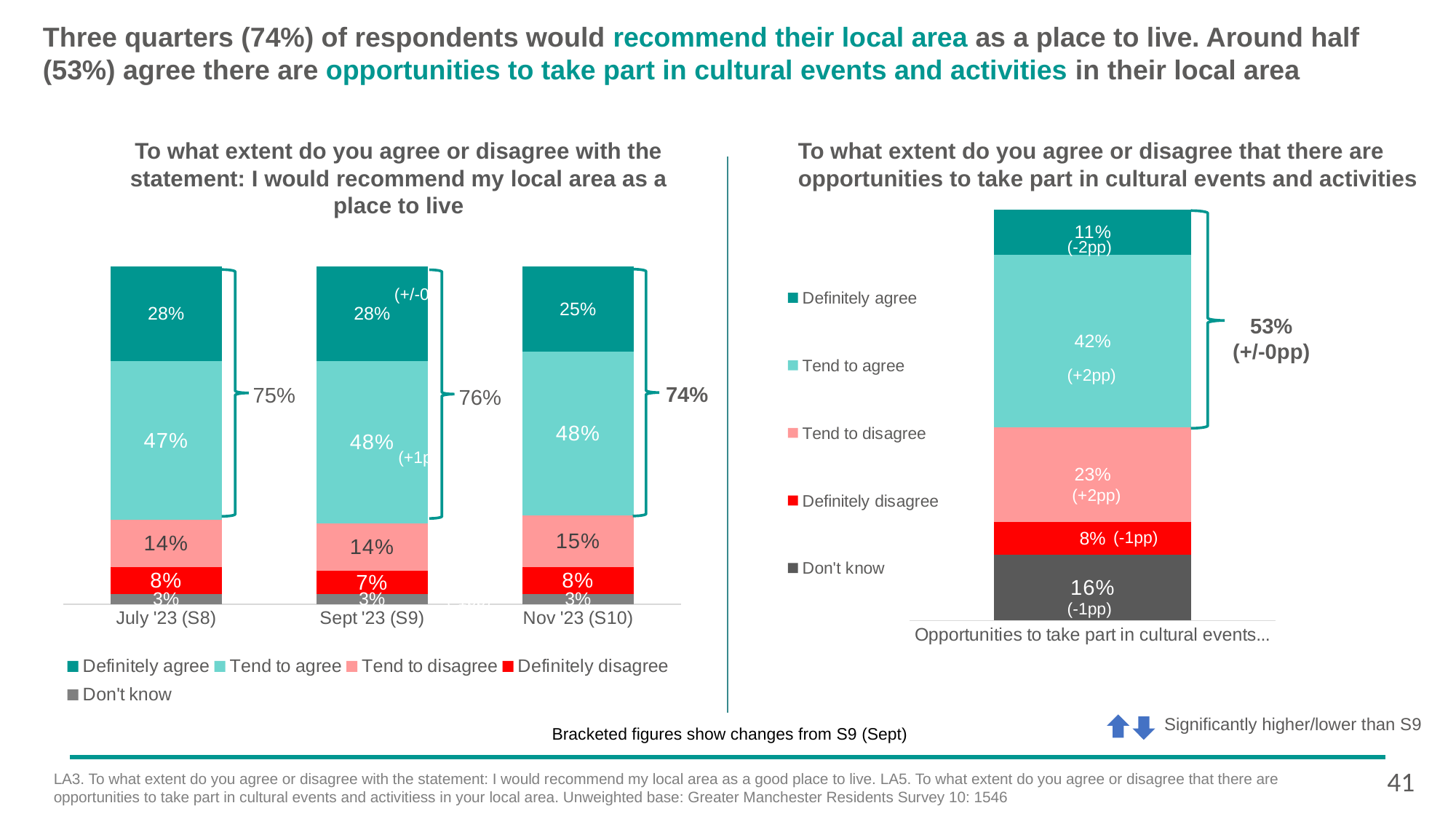
In the left chart (recommend my local area as a place to live), how many time periods are shown on the x axis? 3 What type of chart is used on the right side of the slide? Stacked bar chart In the left chart (recommend my local area as a place to live), which period has the lowest 'Definitely agree' percentage? Nov '23 (S10) In the left chart (recommend my local area as a place to live), what percentage said 'Tend to agree' in July '23 (S8)? 47% In the right chart (opportunities to take part in cultural events and activities), what is the combined agree figure shown by the bracket? 53% (+/-0pp) In the left chart (recommend my local area as a place to live), by how many percentage points did 'Definitely agree' change from Sept '23 (S9) to Nov '23 (S10)? 3 percentage points lower In the left chart (recommend my local area as a place to live), how many series does the legend list? 5 In the right chart (opportunities to take part in cultural events and activities), what percentage said 'Don't know'? 16% In the right chart (opportunities to take part in cultural events and activities), what percentage said 'Tend to agree'? 42% In the left chart (recommend my local area as a place to live), what percentage said 'Definitely disagree' in Sept '23 (S9)? 7% In the left chart (recommend my local area as a place to live), what is the combined agree figure shown by the bracket for Sept '23 (S9)? 76% In the left chart (recommend my local area as a place to live), what percentage of respondents said 'Definitely agree' in Nov '23 (S10)? 25%